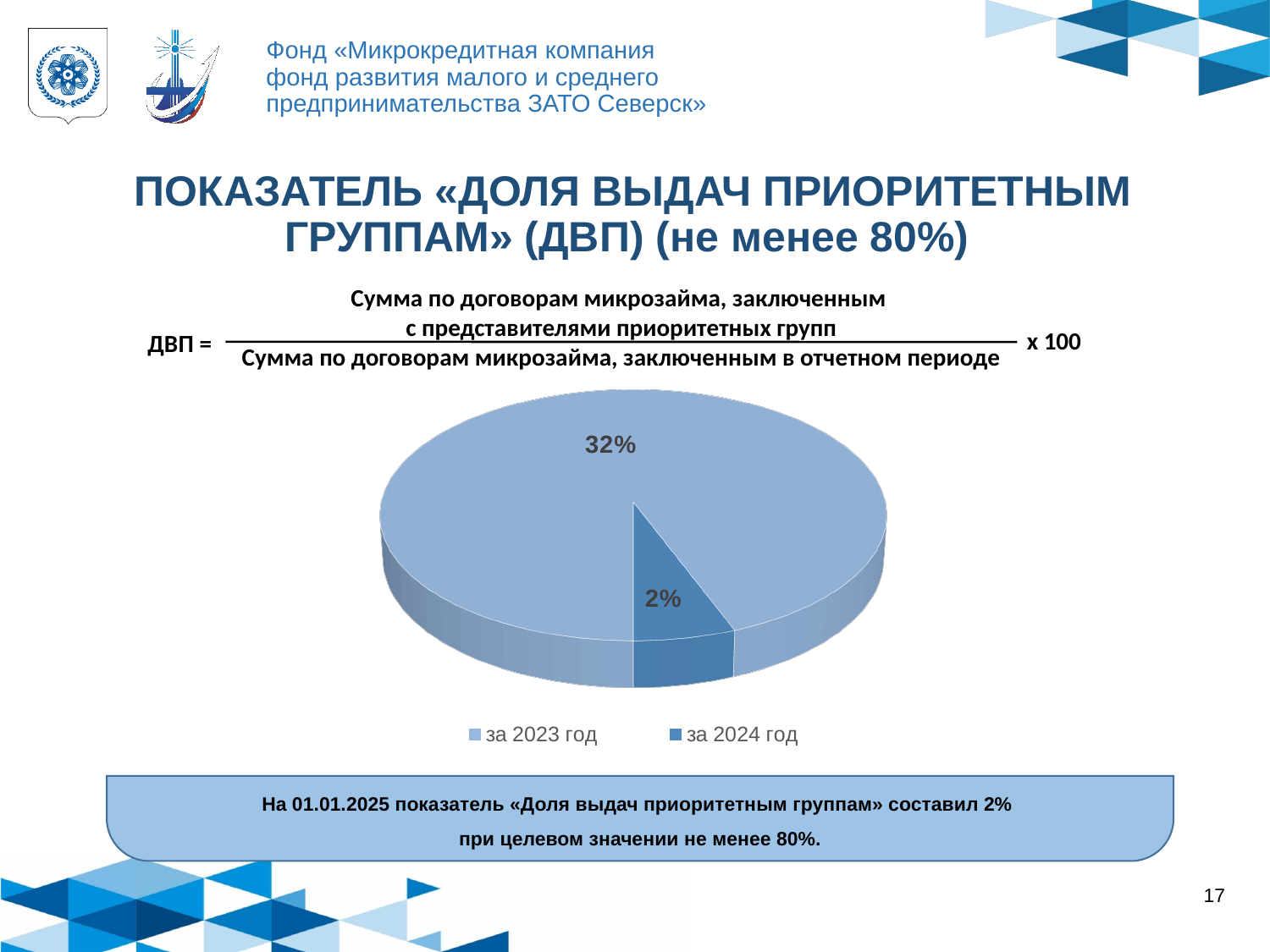
Which slice of the pie chart has the lowest value? за 2024 год What kind of chart is shown on the slide? Pie chart Which is larger: the value for "за 2023 год" or the value for "за 2024 год"? за 2023 год How many slices does the pie chart have? 2 What value is shown for the slice "за 2023 год"? 32% What value is shown for the slice "за 2024 год"? 2% Which slice of the pie chart has the highest value? за 2023 год What are the two legend entries of the chart? за 2023 год, за 2024 год Did the indicator value rise or fall from 2023 to 2024? Fall How many entries does the chart legend list? 2 By how many percentage points does the value for "за 2023 год" exceed the value for "за 2024 год"? 30 Which legend entry is shown in the darker blue colour? за 2024 год